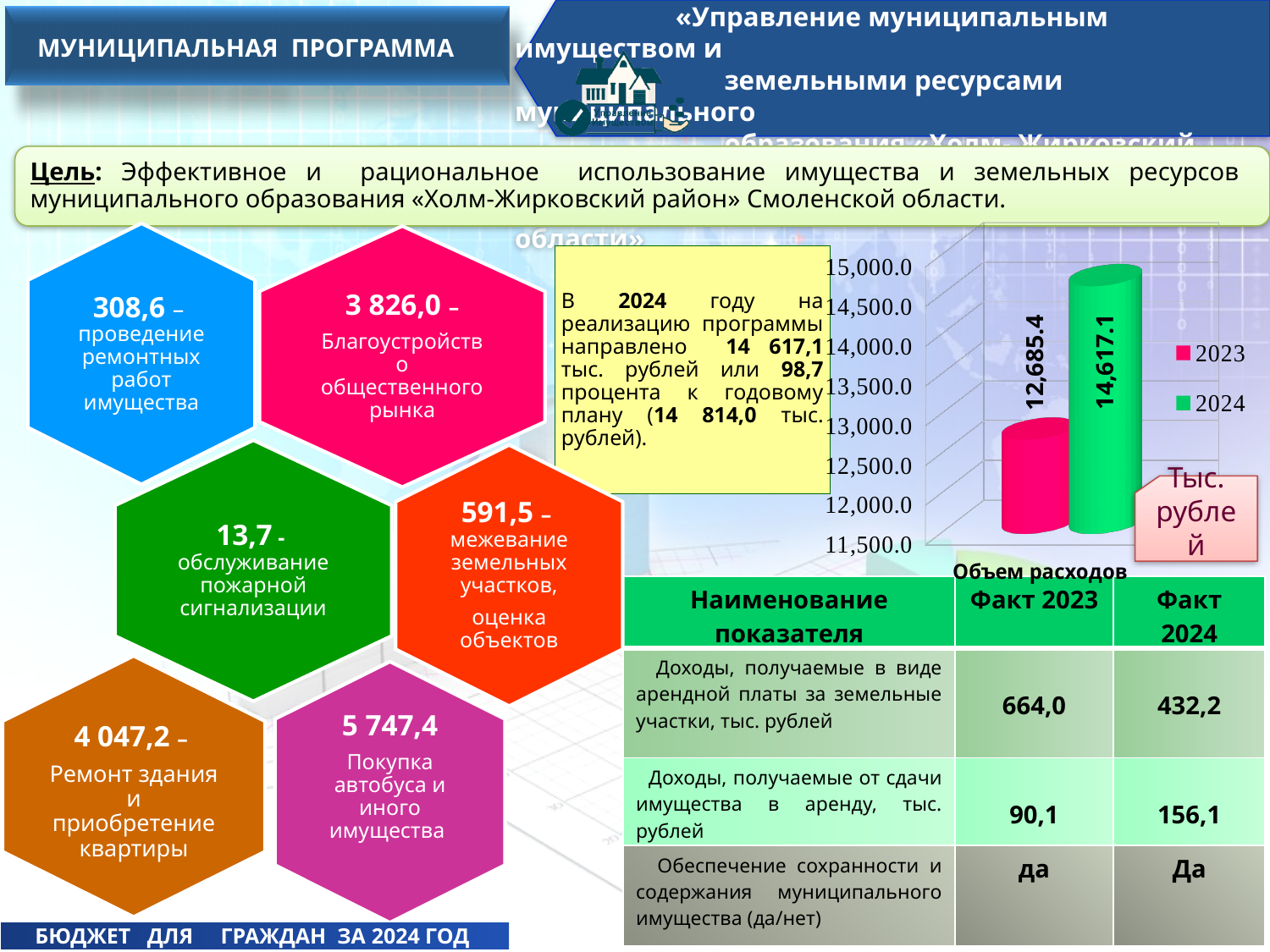
Which year has the higher value in the chart, 2023 or 2024? 2024 What is the difference between the 2024 and 2023 values in the chart? 1,931.7 Is the value for 2024 in the chart greater or less than 14,000.0? greater Is the value for 2023 in the chart greater or less than 13,000.0? less What is the value shown for 2024 in the chart? 14,617.1 What kind of chart is shown on the slide? bar chart How many bars are plotted in the chart? 2 What colour is the bar for 2024 in the chart? green Which year has the lowest value in the chart? 2023 How many entries does the chart legend list? 2 What is the value shown for 2023 in the chart? 12,685.4 Do the values in the chart rise or fall from 2023 to 2024? rise